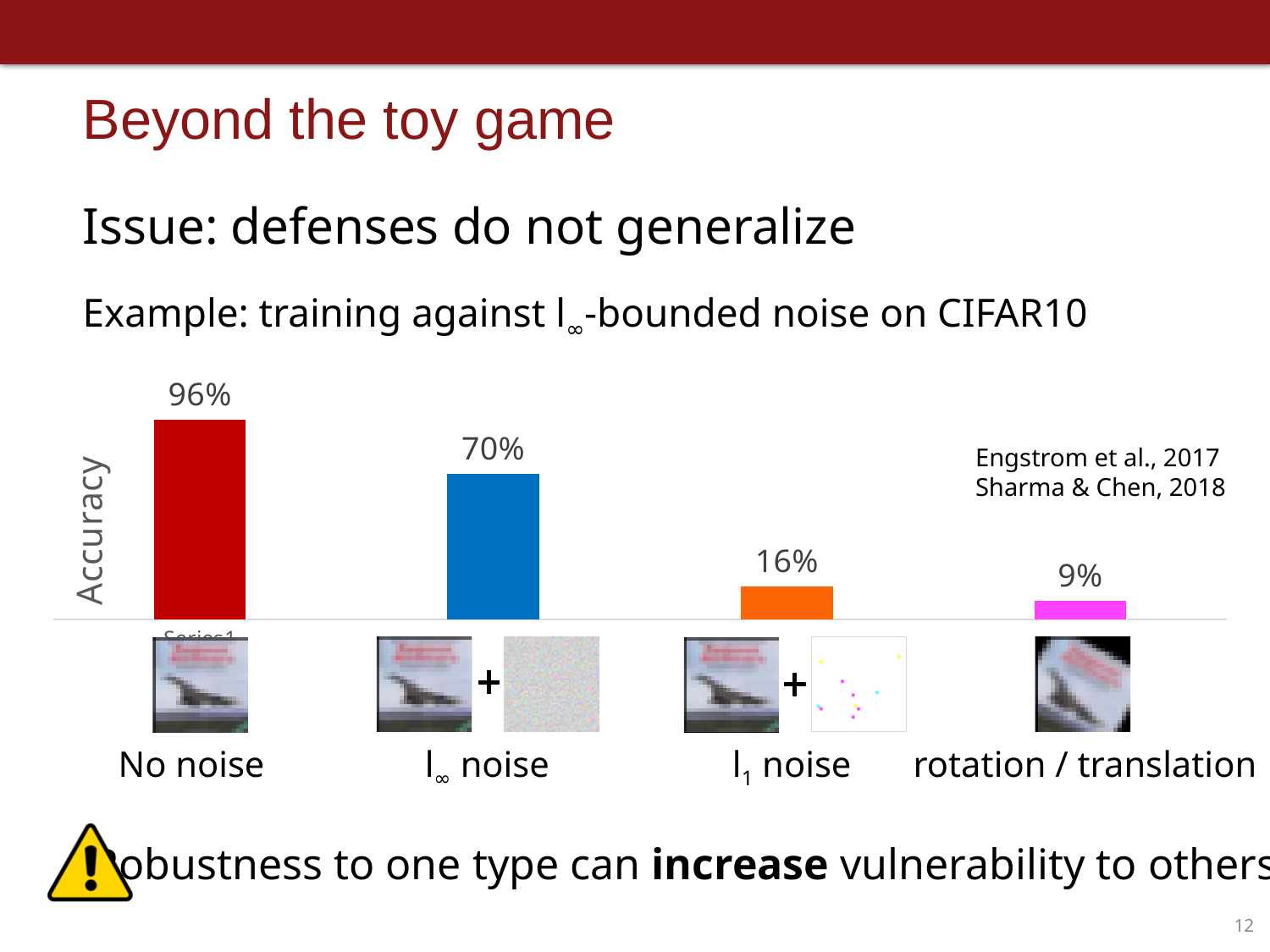
What is the accuracy for rotation / translation? 9% Which has a higher accuracy, l∞ noise or l1 noise? l∞ noise Which category has the highest accuracy? No noise What is the difference in accuracy between l1 noise and rotation / translation? 7% What is the accuracy for l1 noise? 16% How many categories are shown in the chart? 4 What is the accuracy for No noise? 96% What kind of chart is shown on the slide? bar chart What is the difference in accuracy between No noise and l∞ noise? 26% What is the label on the vertical axis of the chart? Accuracy Which category has the lowest accuracy? rotation / translation What is the accuracy for l∞ noise? 70%